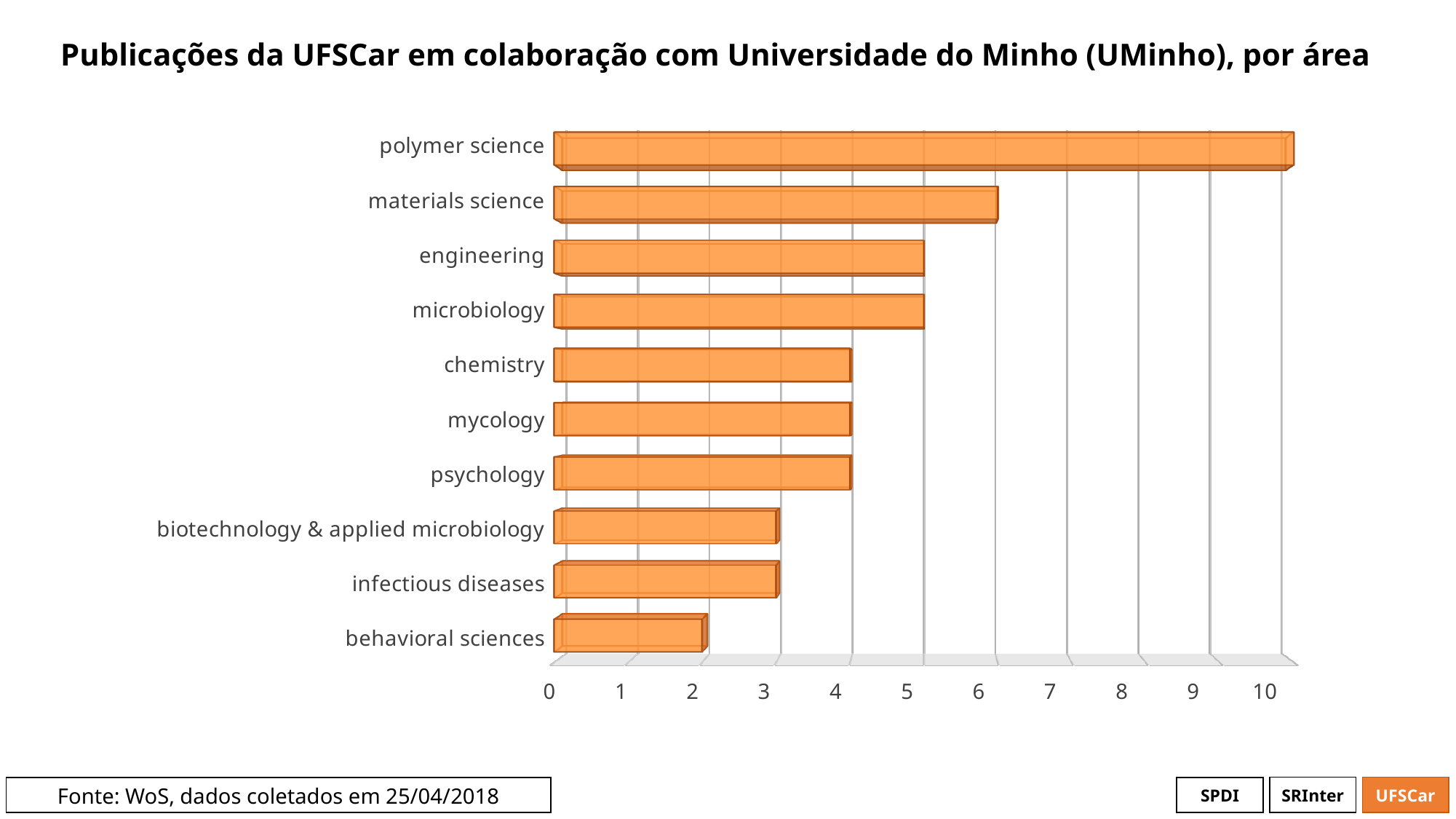
Is the value for polymer science greater or less than 8? greater How many areas (categories) are shown in the chart? 10 What kind of chart is shown on the slide? bar chart How many publications are shown for polymer science? 10 Which has more publications, materials science or chemistry? materials science How many publications are shown for materials science? 6 Is the value for infectious diseases greater or less than 4? less What is the difference in publications between materials science and behavioral sciences? 4 How many publications are shown for behavioral sciences? 2 Which area has the highest number of publications? polymer science What is the title of the chart? Publicações da UFSCar em colaboração com Universidade do Minho (UMinho), por área Which area has the lowest number of publications? behavioral sciences